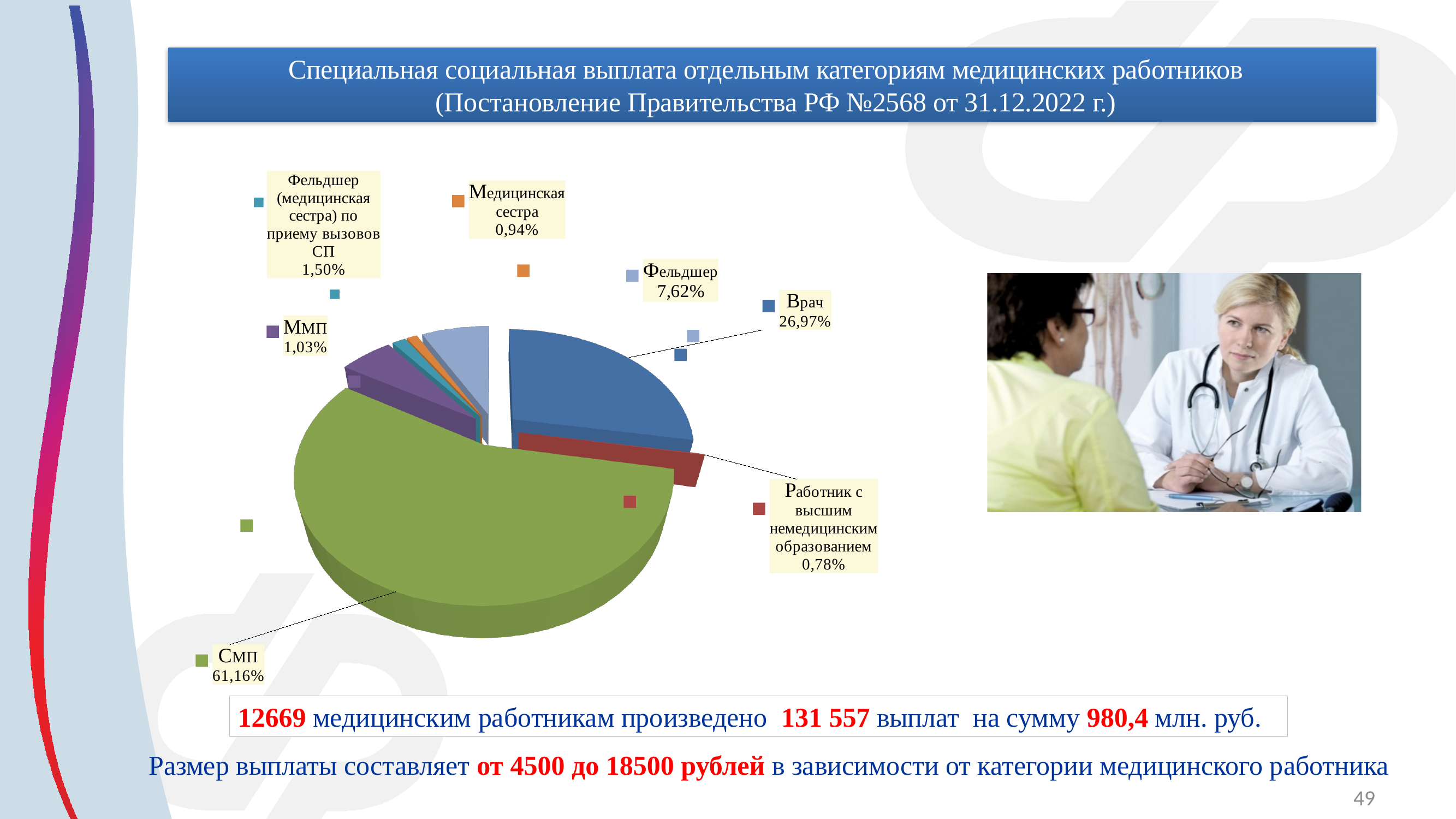
What share of the pie does the Смп slice represent? 61,16% What is the value shown for Работник с высшим немедицинским образованием? 0,78% What is the value shown for Медицинская сестра? 0,94% What share of the pie does the Врач slice represent? 26,97% What is the difference between the shares of Смп and Врач? 34,19% What is the value shown for Ммп? 1,03% Which category has the largest share of the pie? Смп Which is larger, the share for Фельдшер or the share for Ммп? Фельдшер What is the value shown for Фельдшер? 7,62% What kind of chart is shown on the slide? pie chart How many categories (slices) does the pie chart have? 7 Which category has the smallest share of the pie? Работник с высшим немедицинским образованием